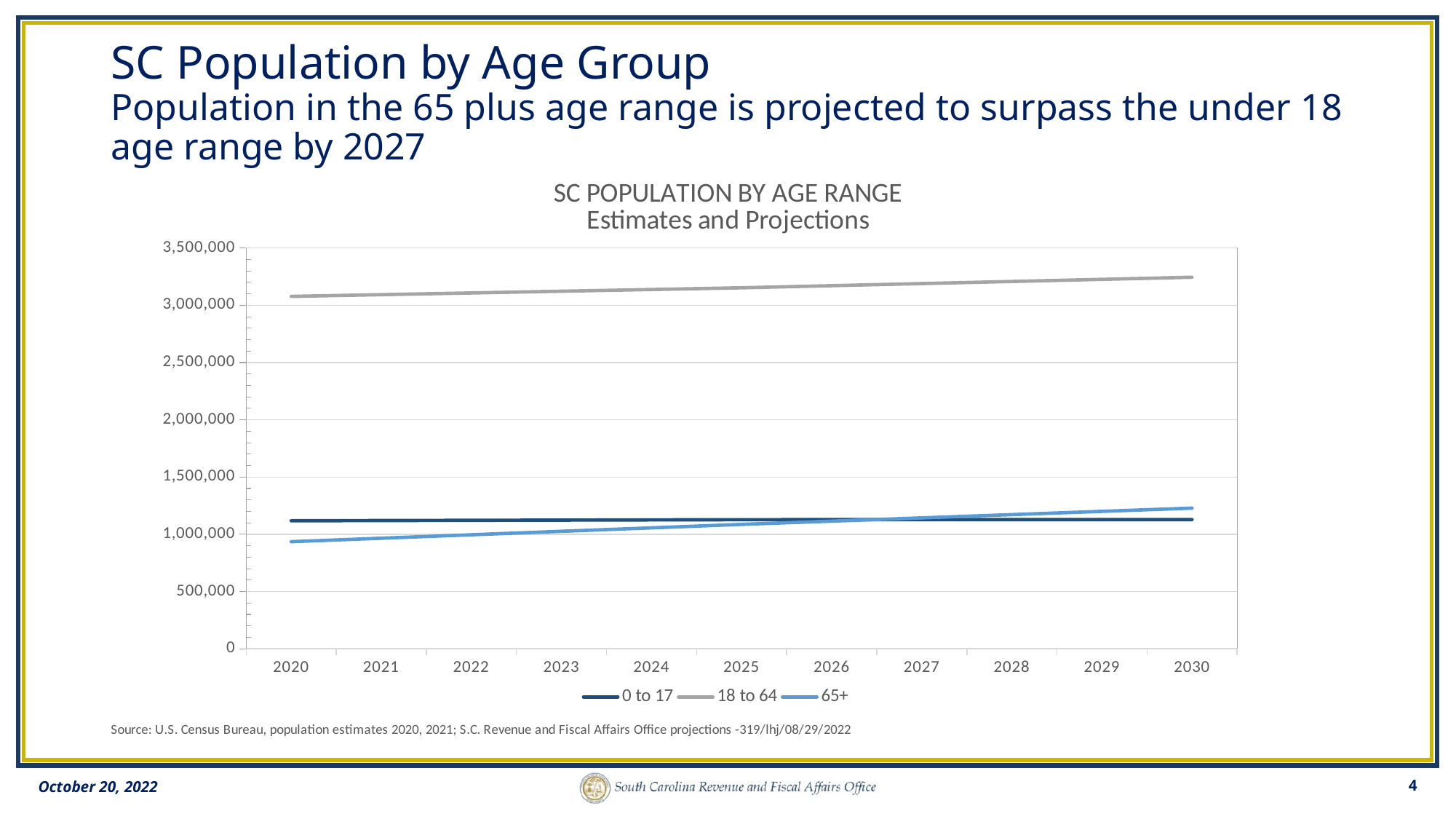
Is the value for 18 to 64 in 2020 greater or less than 3,000,000? greater How many series does the legend list? 3 What kind of chart is shown on the slide? line chart Is the value for 65+ in 2020 greater or less than 1,000,000? less What is the title of the chart? SC POPULATION BY AGE RANGE Estimates and Projections In 2030, which is larger: the 65+ population or the 0 to 17 population? 65+ How many years are shown on the x axis? 11 Which age range has the highest population across all years? 18 to 64 Is the value for 65+ in 2030 greater or less than 1,000,000? greater Which age range has the lowest population in 2020? 65+ Does the 65+ line rise or fall from 2020 to 2030? rises In 2020, which is larger: the 0 to 17 population or the 65+ population? 0 to 17